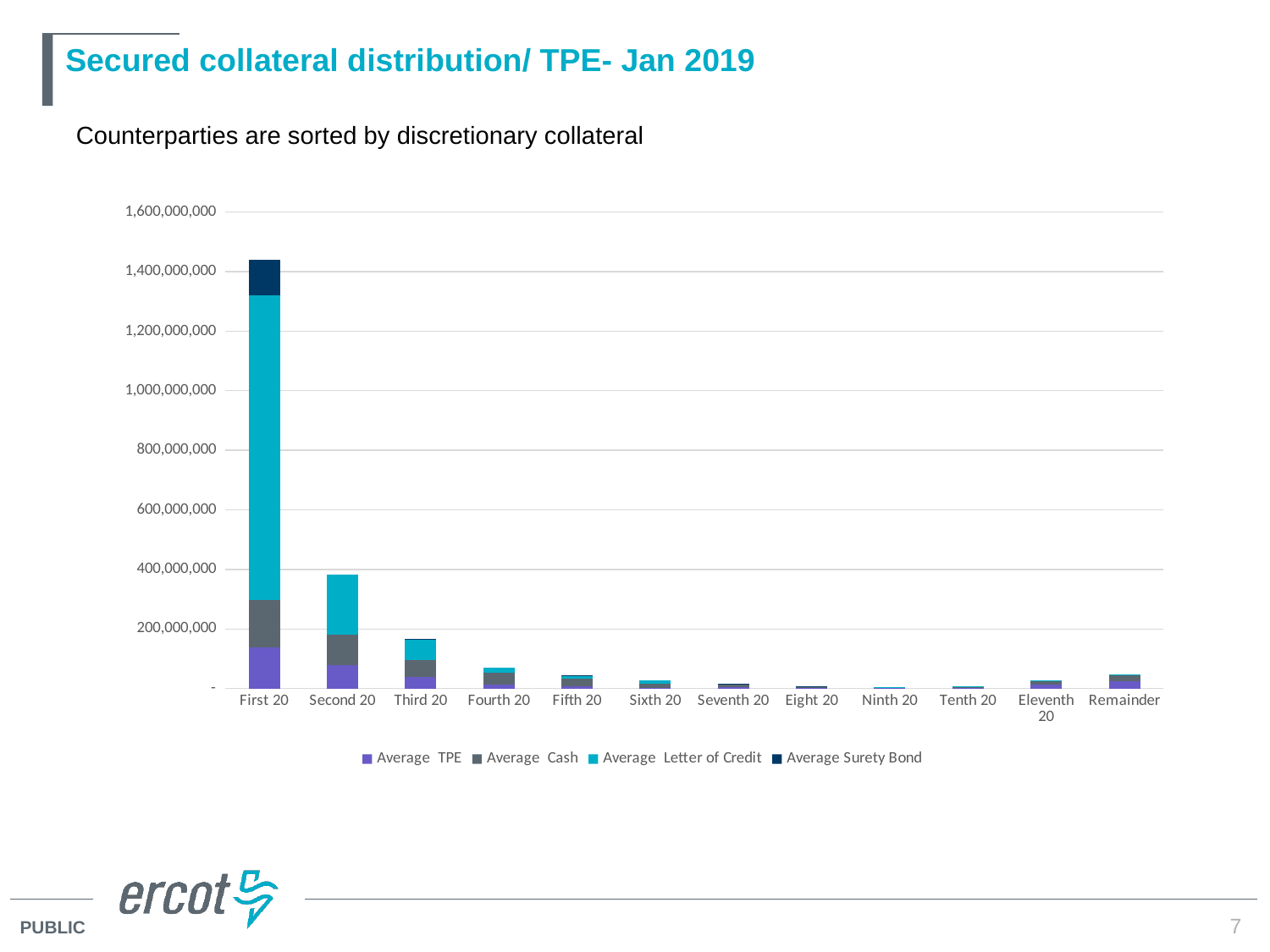
Is the total stacked value for Third 20 greater or less than 200,000,000? less How many series does the chart legend list? 4 What kind of chart is shown on the slide? Stacked bar chart Which series is shown in the dark navy colour in the legend? Average Surety Bond Is the total stacked value for First 20 greater or less than 1,200,000,000? greater Which has the larger stacked bar, Fourth 20 or Fifth 20? Fourth 20 How many categories are shown along the x axis of the chart? 12 What is the title of the slide containing the chart? Secured collateral distribution/ TPE- Jan 2019 Which category has the tallest stacked bar? First 20 Is the total stacked value for Second 20 greater or less than 200,000,000? greater Which has the larger stacked bar, First 20 or Second 20? First 20 Do the stacked bar totals generally rise or fall from First 20 to Tenth 20? fall